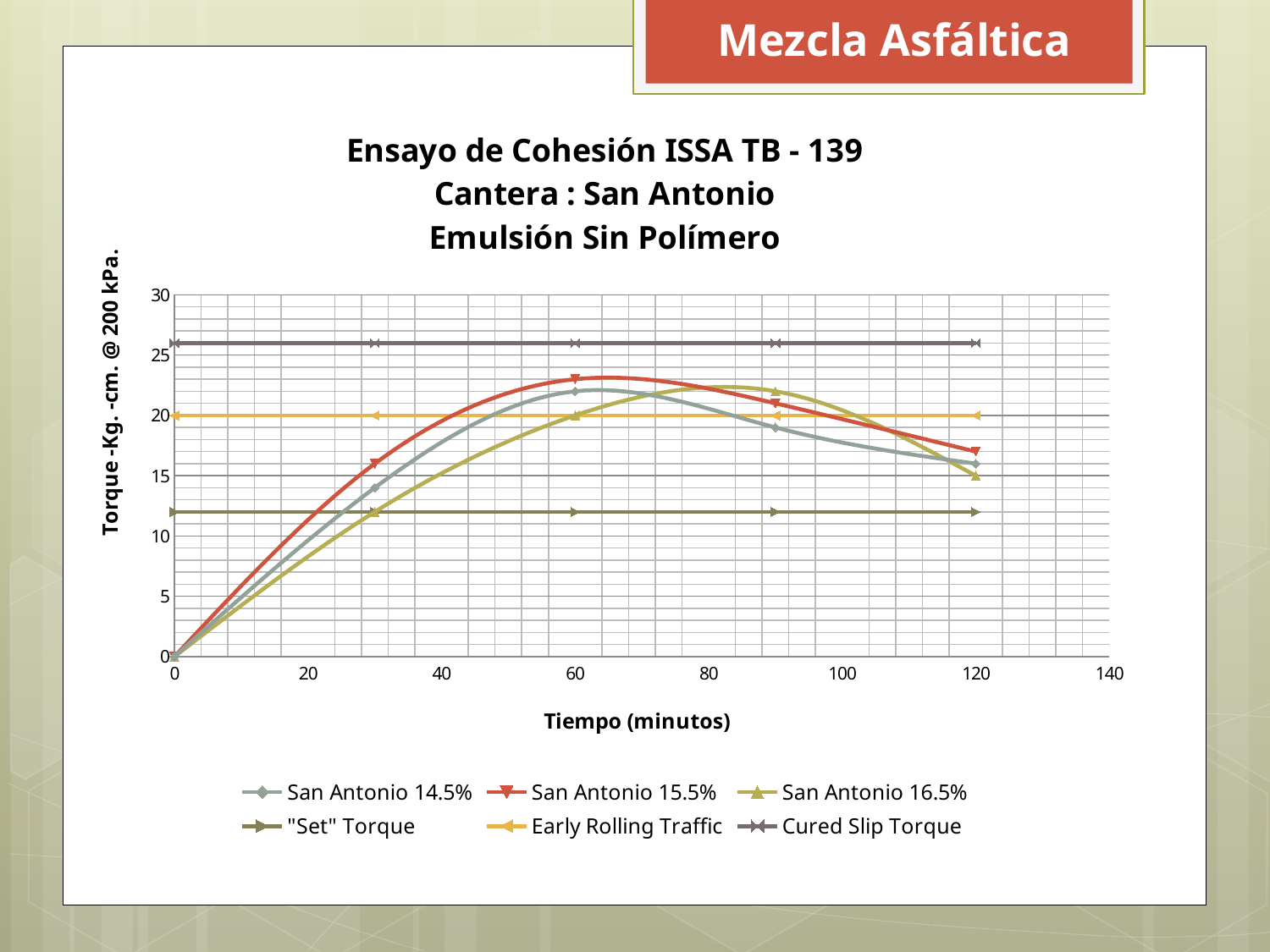
Is the value of the "Set" Torque line greater or less than 15? less At 30 minutes, which is larger: San Antonio 15.5% or San Antonio 16.5%? San Antonio 15.5% At 30 minutes, which of the three San Antonio series has the highest torque? San Antonio 15.5% Does the San Antonio 14.5% series rise or fall between 60 and 120 minutes? fall At 120 minutes, which is larger: San Antonio 15.5% or San Antonio 16.5%? San Antonio 15.5% Is the value for San Antonio 16.5% at 30 minutes greater or less than 15? less Is the value of the Cured Slip Torque line greater or less than 25? greater What is the constant value of the Early Rolling Traffic line? 20 What kind of chart is shown on the slide? line chart How many series does the legend list? 6 What is the title of the x axis? Tiempo (minutos)